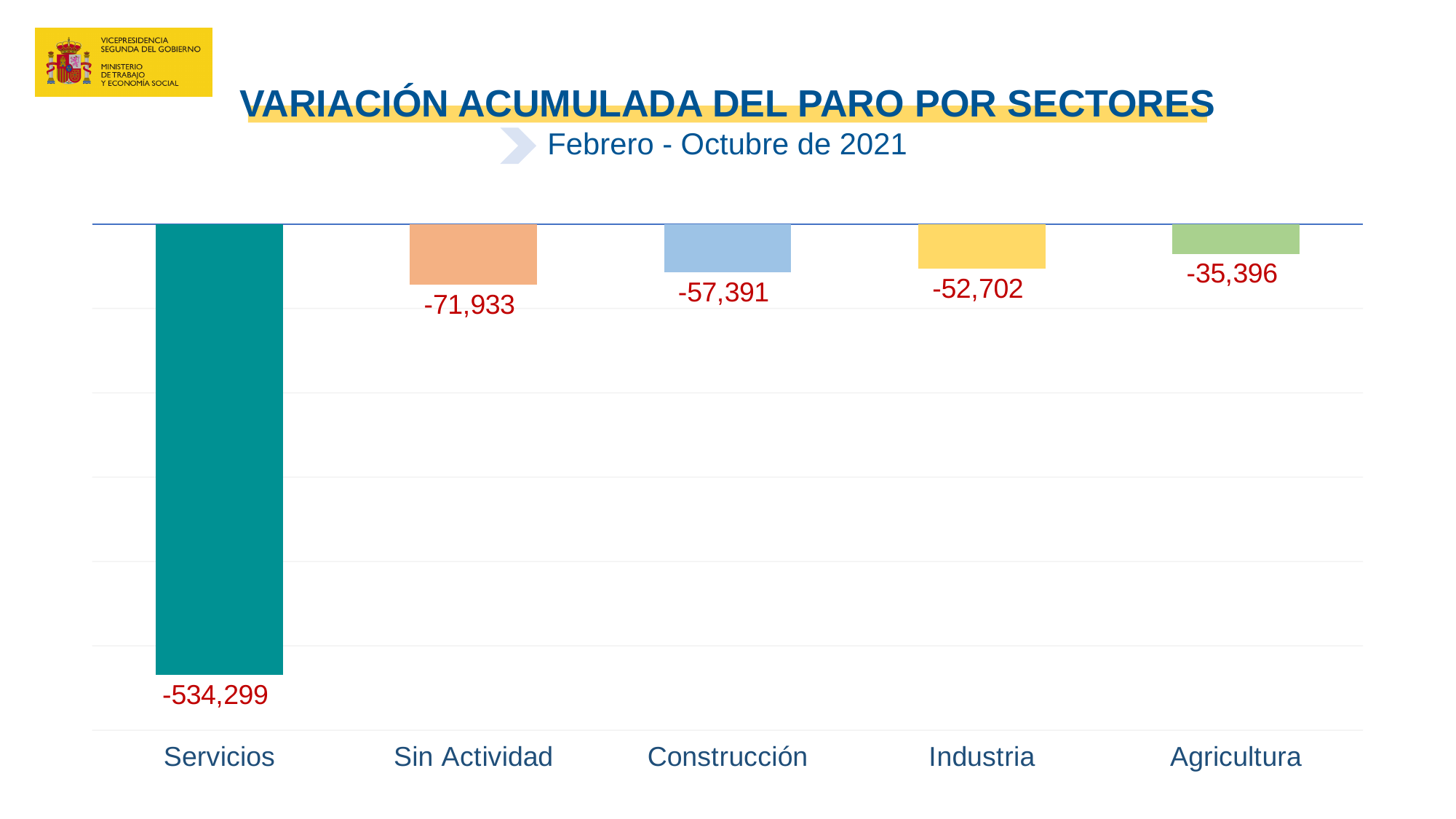
What is the value shown for Industria? -52,702 Which sector has a larger decrease, Construcción or Industria? Construcción What is the value shown for Servicios? -534,299 How many sectors are shown in the chart? 5 Which sector shows the smallest decrease (the highest value)? Agricultura What kind of chart is shown on the slide? Bar chart What is the value shown for Agricultura? -35,396 What is the value shown for Sin Actividad? -71,933 Which sector shows the largest decrease (the lowest value)? Servicios By how much does the decrease for Industria exceed the decrease for Agricultura? 17,306 What is the value shown for Construcción? -57,391 By how much does the decrease for Sin Actividad exceed the decrease for Construcción? 14,542